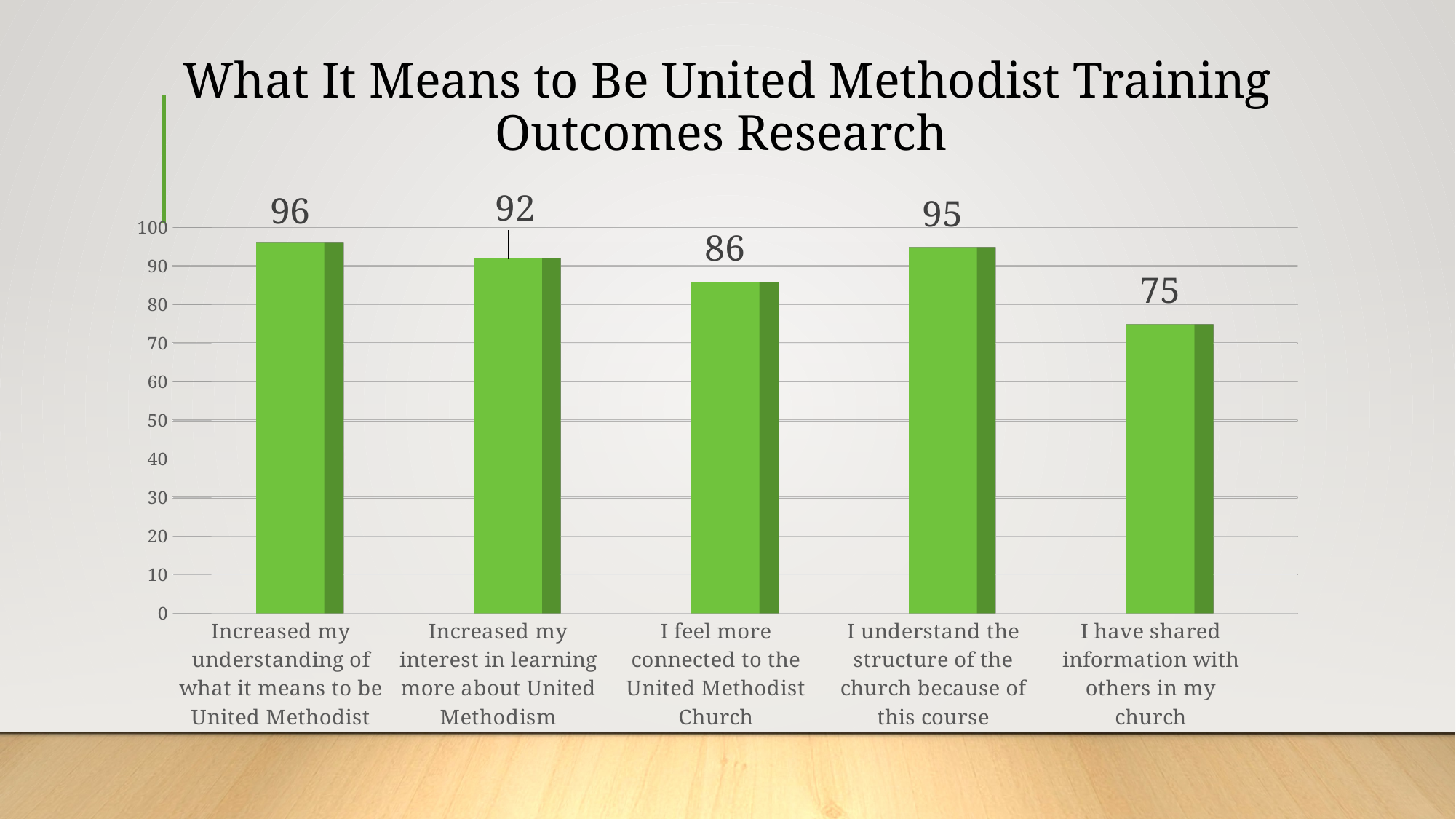
What is the value for "I feel more connected to the United Methodist Church"? 86 Which is larger: the value for "Increased my interest in learning more about United Methodism" or the value for "I feel more connected to the United Methodist Church"? Increased my interest in learning more about United Methodism What kind of chart is shown on the slide? bar chart Which category has the lowest value? I have shared information with others in my church Is the value for "I feel more connected to the United Methodist Church" greater or less than 90? less What is the value for "I understand the structure of the church because of this course"? 95 Which category has the highest value? Increased my understanding of what it means to be United Methodist What is the difference between the values for "Increased my understanding of what it means to be United Methodist" and "I have shared information with others in my church"? 21 What is the value for "I have shared information with others in my church"? 75 What is the title of the slide? What It Means to Be United Methodist Training Outcomes Research How many categories are shown in the chart? 5 What is the value for "Increased my understanding of what it means to be United Methodist"? 96